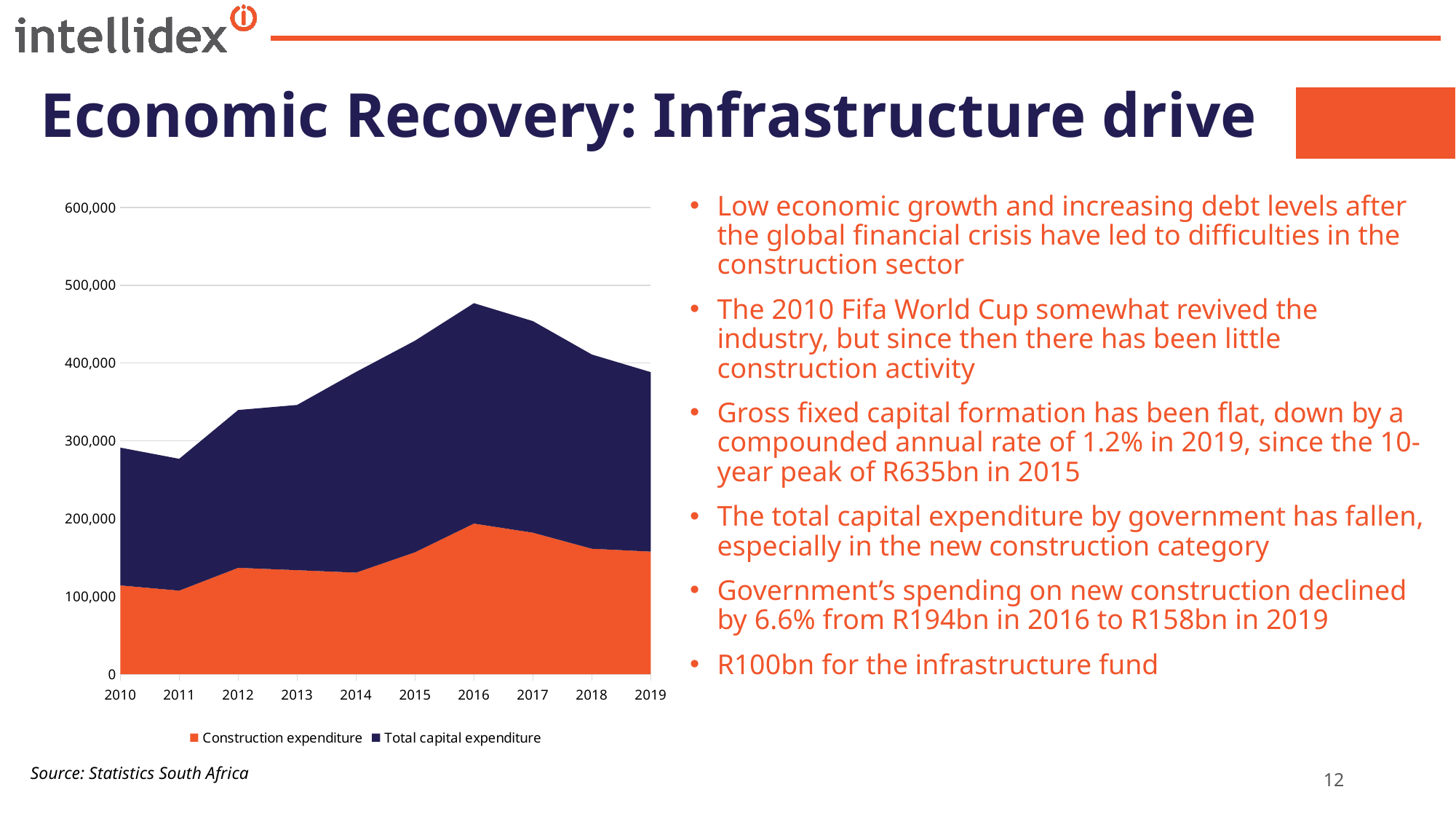
Is the value for Construction expenditure in 2016 greater or less than 100,000? greater What kind of chart is shown on the slide? Area chart How many years are shown on the x axis of the chart? 10 In which year is the top of the stacked area (Total capital expenditure) at its highest? 2016 Is the top of the stacked area in 2011 greater or less than 300,000? less In which year is the top of the stacked area at its lowest? 2011 Which colour represents Total capital expenditure in the chart? Dark navy blue In which year does Construction expenditure reach its highest point? 2016 How many series does the chart legend list? 2 Does Construction expenditure rise or fall from 2016 to 2019? Fall Is the top of the stacked area in 2016 greater or less than 500,000? less Which is larger: Construction expenditure in 2016 or in 2010? 2016